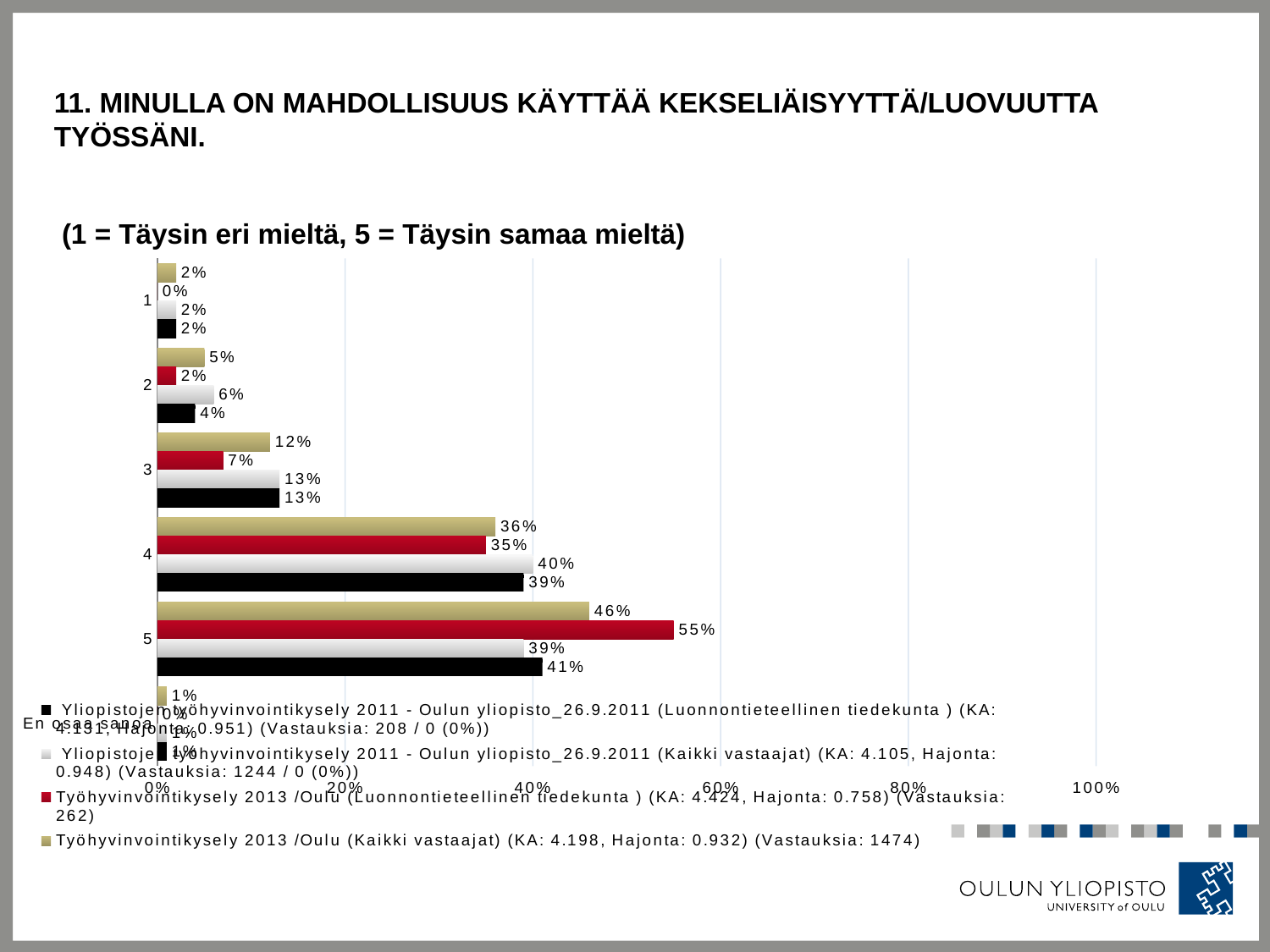
How many series does the legend list? 4 What type of chart is shown on the slide? bar chart What is the value for category 3 in the Työhyvinvointikysely 2013 /Oulu (Kaikki vastaajat) series? 12% What is the value for category 2 in the Yliopistojen työhyvinvointikysely 2011 (Luonnontieteellinen tiedekunta) series? 4% Which series has the lowest value for category 3? Työhyvinvointikysely 2013 /Oulu (Luonnontieteellinen tiedekunta) Which series has the highest value for category 5? Työhyvinvointikysely 2013 /Oulu (Luonnontieteellinen tiedekunta) What is the value for category 5 in the Työhyvinvointikysely 2013 /Oulu (Luonnontieteellinen tiedekunta) series? 55% For the Työhyvinvointikysely 2013 /Oulu (Kaikki vastaajat) series, which is larger: the value for category 4 or category 5? category 5 What is the difference between the Työhyvinvointikysely 2013 /Oulu (Luonnontieteellinen tiedekunta) value for category 5 and its value for category 4? 20% What is the value for category 4 in the Yliopistojen työhyvinvointikysely 2011 (Kaikki vastaajat) series? 40% What is the value for category 1 in the Työhyvinvointikysely 2013 /Oulu (Luonnontieteellinen tiedekunta) series? 0% Is the value for category 5 in the Työhyvinvointikysely 2013 /Oulu (Luonnontieteellinen tiedekunta) series greater or less than 40%? greater